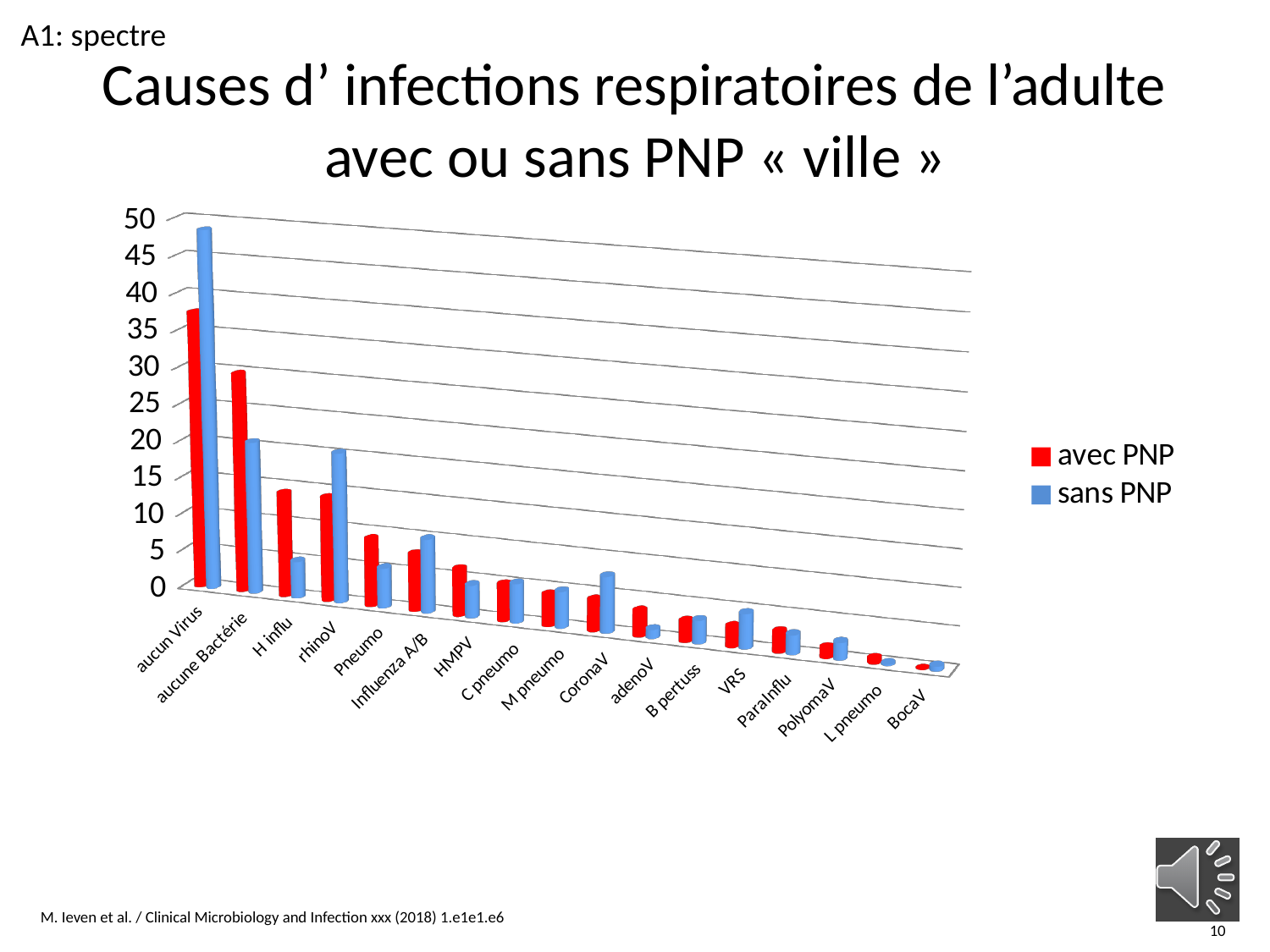
For aucune Bactérie, which series has the larger value, avec PNP or sans PNP? avec PNP How many categories are shown on the x axis? 17 What kind of chart is shown on the slide? bar chart Is the sans PNP value for aucun Virus greater or less than 40? greater Which category has the highest value for the sans PNP series? aucun Virus Is the avec PNP value for H influ greater or less than 10? greater Which category has the highest value for the avec PNP series? aucun Virus How many series does the legend list? 2 Which colour represents the avec PNP series in the legend? red Is the sans PNP value for H influ greater or less than 10? less For rhinoV, which series has the larger value, avec PNP or sans PNP? sans PNP